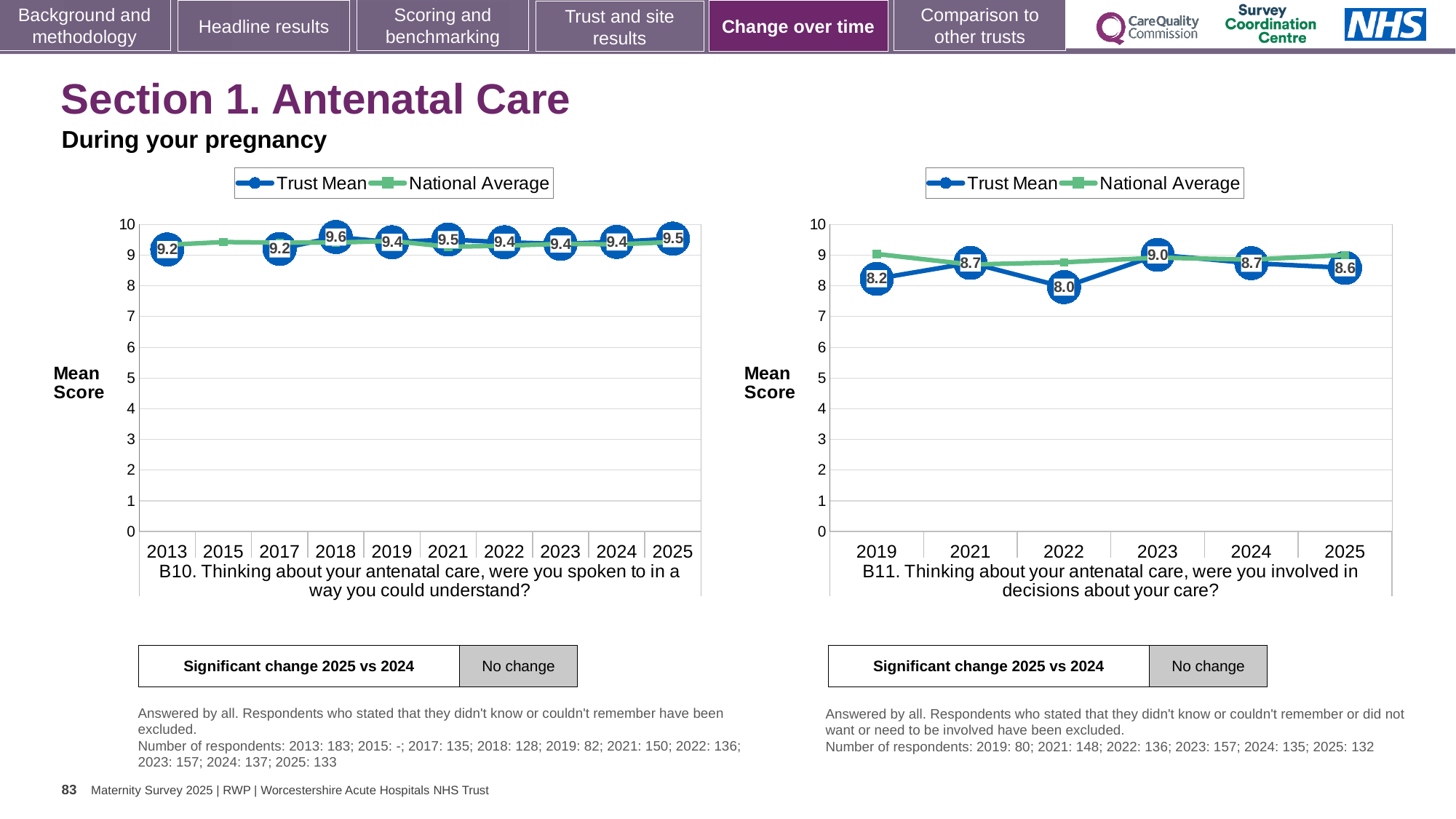
In the B11 chart on the right, what is the Trust Mean score for 2022? 8.0 In the B11 chart on the right, which year has the lowest Trust Mean score? 2022 What kind of chart is the B11 chart on the right? Line chart In the B11 chart on the right, what is the difference between the Trust Mean scores for 2023 and 2022? 1.0 In the B10 chart on the left, what is the Trust Mean score for 2018? 9.6 How many series does the legend of the B11 chart on the right list? 2 In the B11 chart on the right, is the Trust Mean score higher in 2019 or 2021? 2021 In the B11 chart on the right, which year has the highest Trust Mean score? 2023 In the B10 chart on the left, is the National Average value for 2015 greater or less than 9? greater In the B10 chart on the left, which year has the highest Trust Mean score? 2018 In the B10 chart on the left, what is the difference between the Trust Mean scores for 2018 and 2017? 0.4 How many years are shown on the x axis of the B10 chart on the left? 10